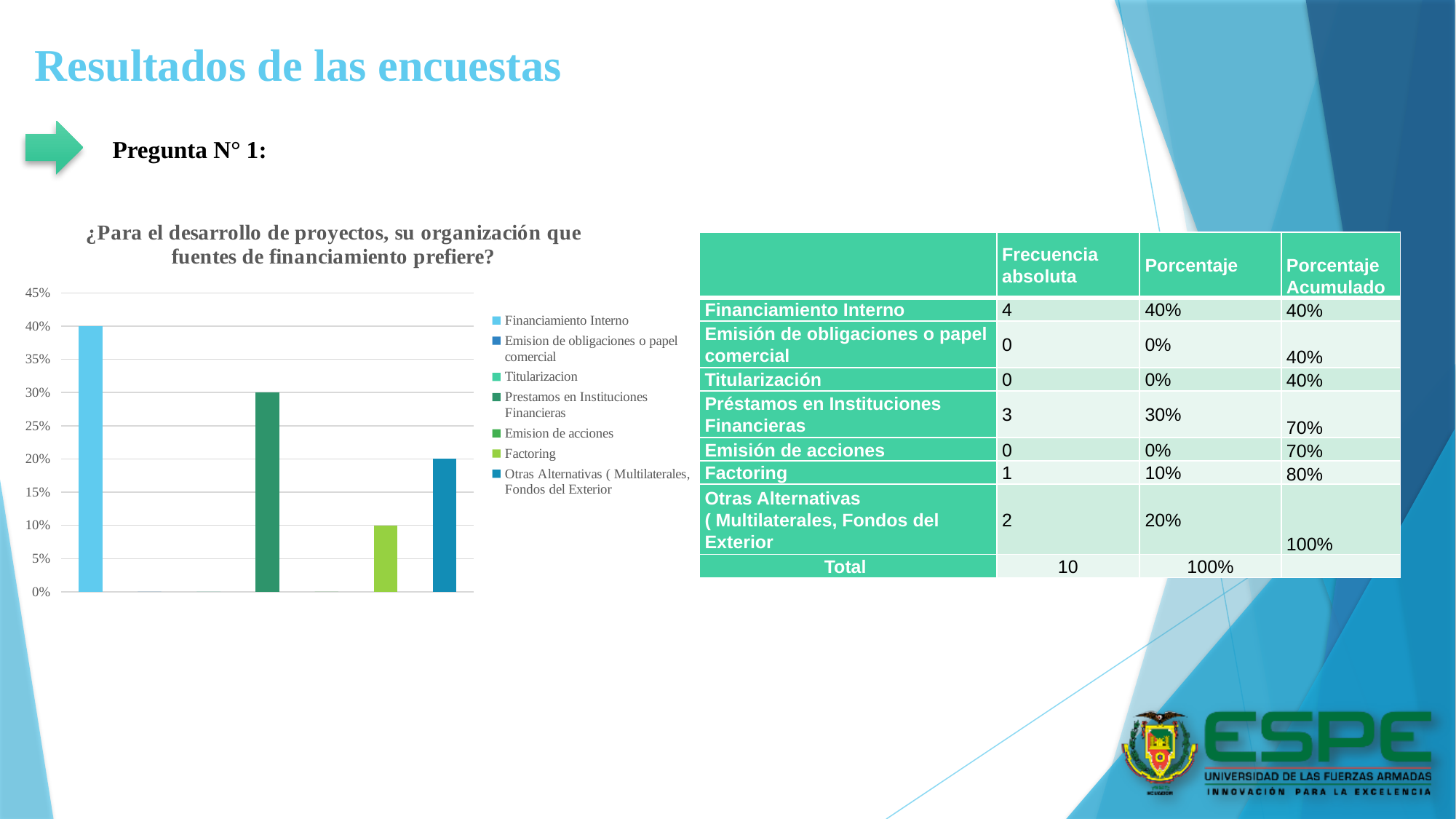
What is the title of the chart? ¿Para el desarrollo de proyectos, su organización que fuentes de financiamiento prefiere? What is the highest value shown on the vertical axis? 45% How many series does the legend list? 7 What is the value for Financiamiento Interno? 40% What kind of chart is shown? bar chart What is the value for Otras Alternativas (Multilaterales, Fondos del Exterior)? 20% Is the value for Prestamos en Instituciones Financieras greater or less than 25%? greater Which is larger, the value for Otras Alternativas (Multilaterales, Fondos del Exterior) or the value for Factoring? Otras Alternativas (Multilaterales, Fondos del Exterior) What is the difference between the values for Financiamiento Interno and Prestamos en Instituciones Financieras? 10% What is the value for Prestamos en Instituciones Financieras? 30% Which category has the highest value? Financiamiento Interno What is the value for Factoring? 10%